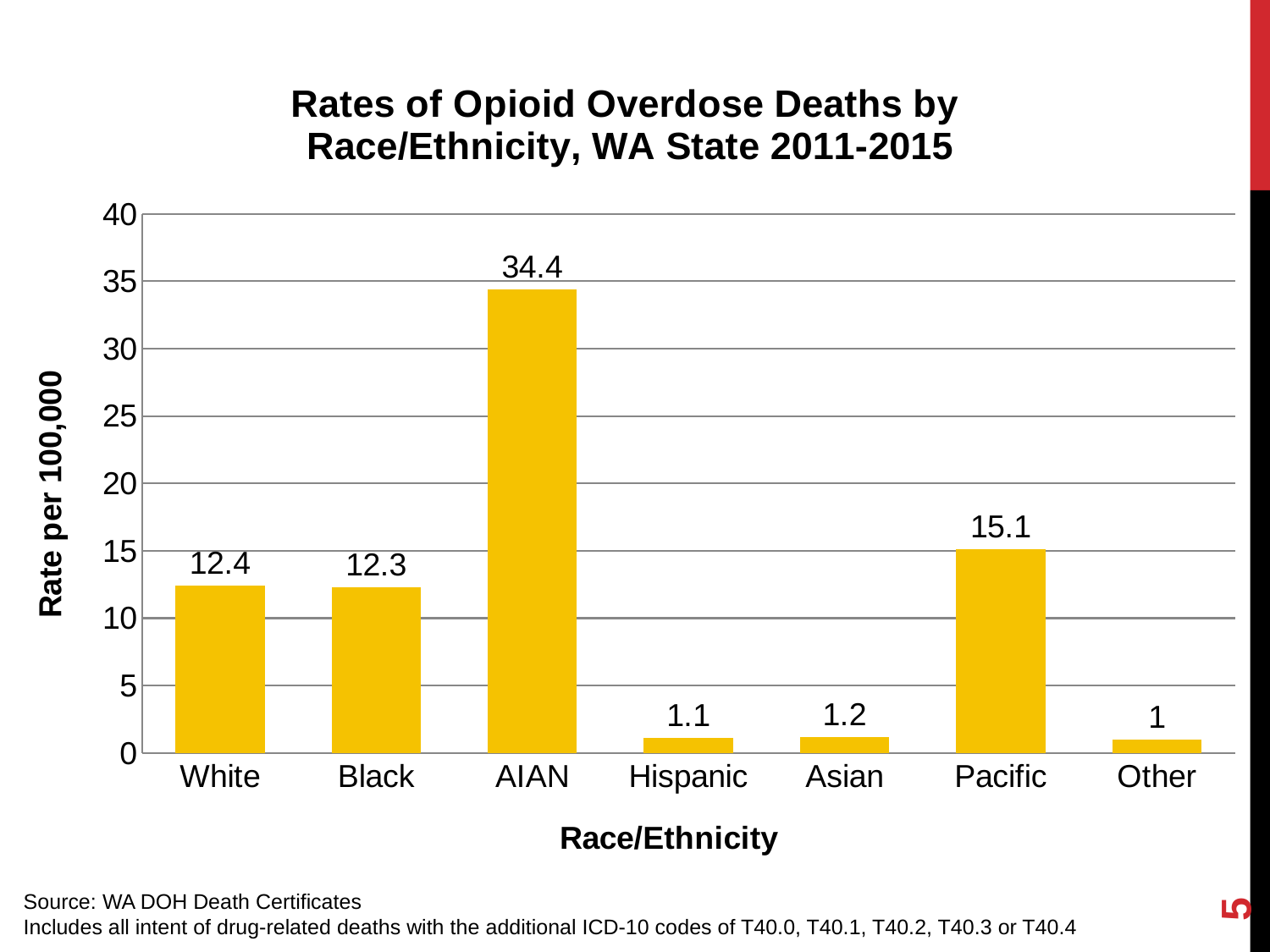
Which has a higher rate of opioid overdose deaths, Pacific or White? Pacific What is the label of the y axis? Rate per 100,000 What is the rate of opioid overdose deaths for AIAN? 34.4 What is the rate of opioid overdose deaths for Hispanic? 1.1 How many race/ethnicity categories are shown on the chart? 7 Is the rate for AIAN greater or less than 30? greater What is the difference between the rates for AIAN and Pacific? 19.3 Which race/ethnicity has the highest rate of opioid overdose deaths? AIAN What is the rate of opioid overdose deaths for Pacific? 15.1 What is the difference between the rates for White and Black? 0.1 Which race/ethnicity has the lowest rate of opioid overdose deaths? Other What kind of chart is shown on the slide? Bar chart